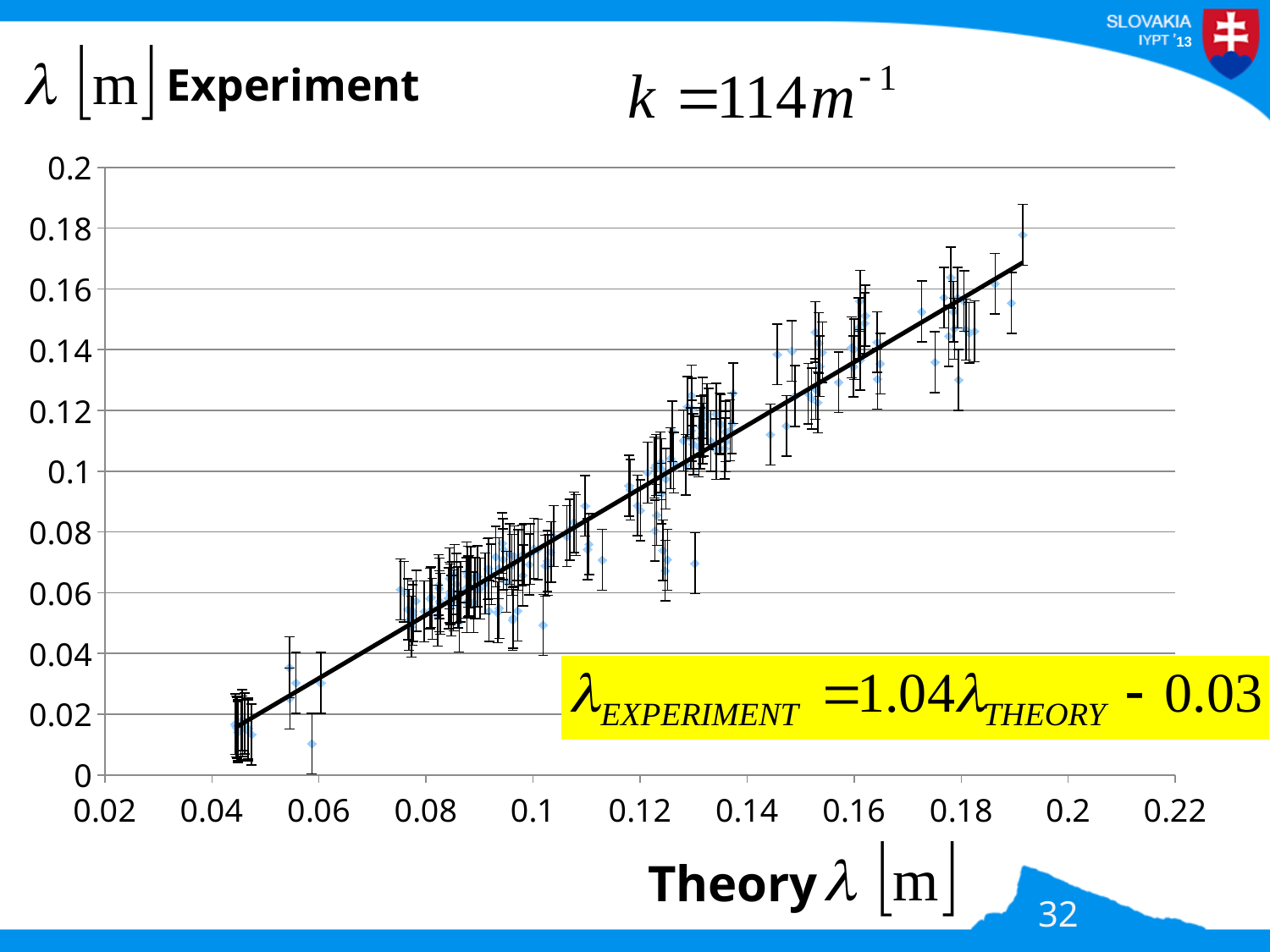
What is the slope of the fitted line relating experimental to theoretical wavelength? 1.04 What is the highest tick value shown on the y axis? 0.2 What is the intercept of the fitted line relating experimental to theoretical wavelength? -0.03 Is the experimental value for the rightmost data point (theory about 0.19 m) greater or less than 0.16? greater What is the label of the y axis? λ [m] Experiment What is the fitted relationship between the experimental and theoretical wavelengths shown in the yellow box? λ_EXPERIMENT = 1.04 λ_THEORY - 0.03 What is the label of the x axis? Theory λ [m] Are the experimental values for the leftmost cluster of points (theory about 0.045 m) greater or less than 0.04? less Do the experimental values rise or fall as the theoretical wavelength increases along the x axis? rise What is the highest tick value shown on the x axis? 0.22 What kind of chart is shown on the slide? scatter chart What value of k is given at the top of the slide? 114 m^-1